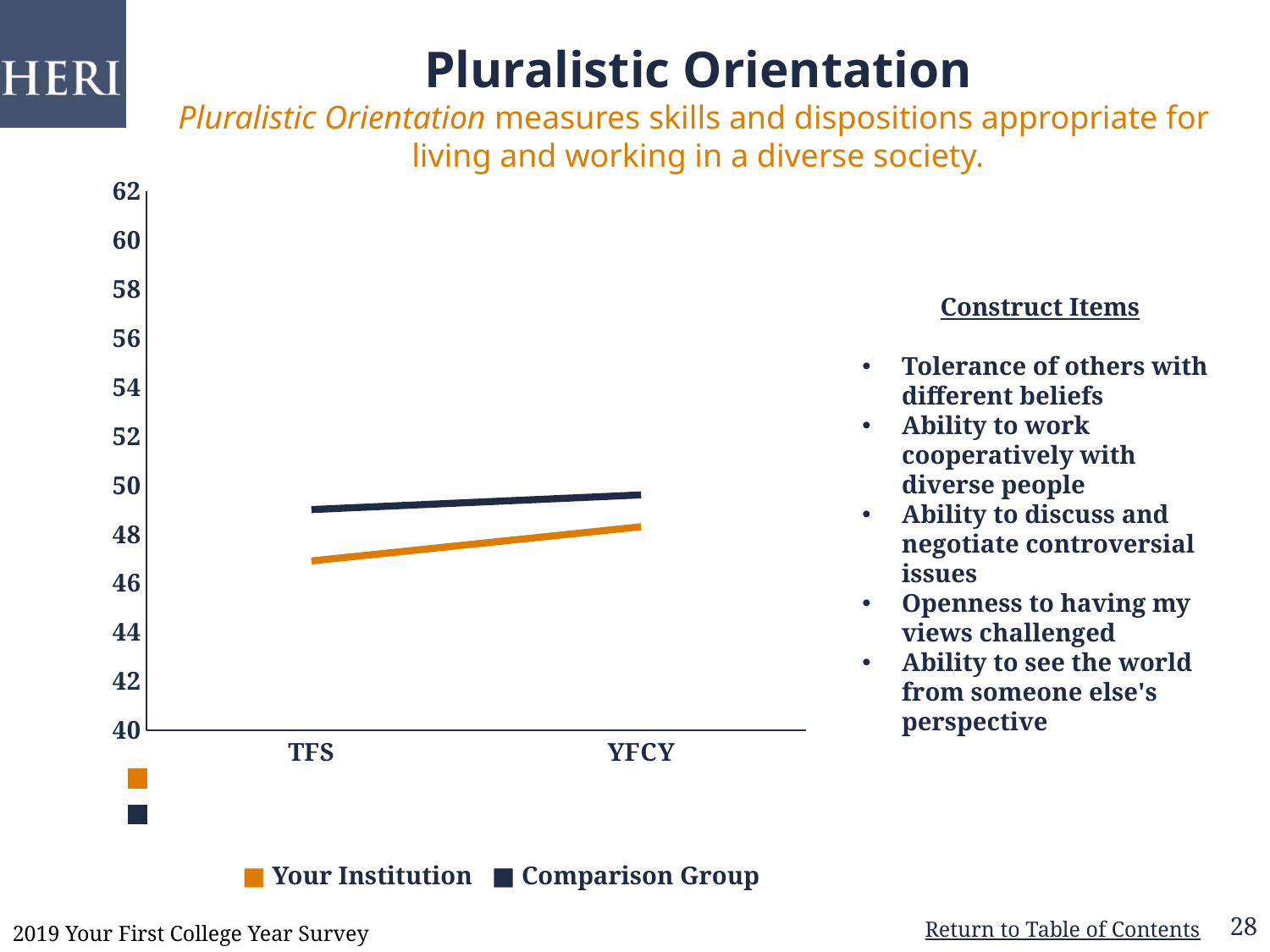
At TFS, which series has the higher value, Your Institution or Comparison Group? Comparison Group Is the value for Your Institution at YFCY greater or less than 46? greater Is the value for Comparison Group at TFS greater or less than 48? greater How many series does the chart legend list? 2 What kind of chart is shown on the slide? line chart Which series is drawn in orange in the chart? Your Institution At YFCY, which series has the higher value, Your Institution or Comparison Group? Comparison Group Is the value for Your Institution at TFS greater or less than 48? less What are the two categories on the x axis of the chart? TFS and YFCY Does the Your Institution line rise or fall from TFS to YFCY? rise How many categories are shown on the x axis of the chart? 2